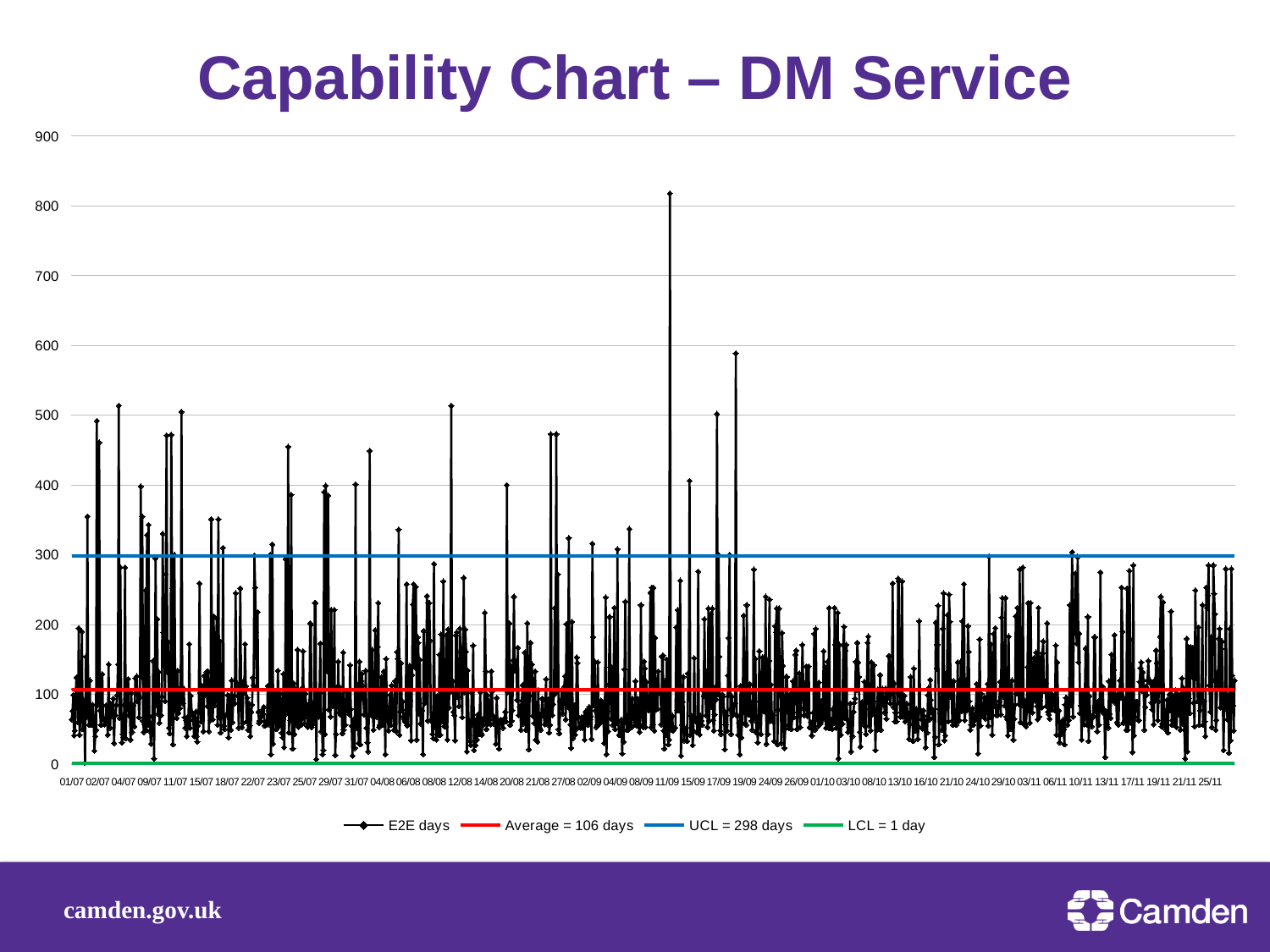
What kind of chart is shown on the slide? line chart What is the title of the chart? Capability Chart – DM Service Is the highest E2E days spike on the chart greater or less than 700? greater Is the highest E2E days spike on the chart greater or less than 900? less How many series does the legend list? 4 What colour is the UCL line on the chart? blue What value does the legend give for the LCL line? 1 day What is the difference between the UCL value and the Average value? 192 days Which is larger, the UCL value or the Average value? UCL What value does the legend give for the Average line? 106 days What is the difference between the Average value and the LCL value? 105 days What value does the legend give for the UCL line? 298 days